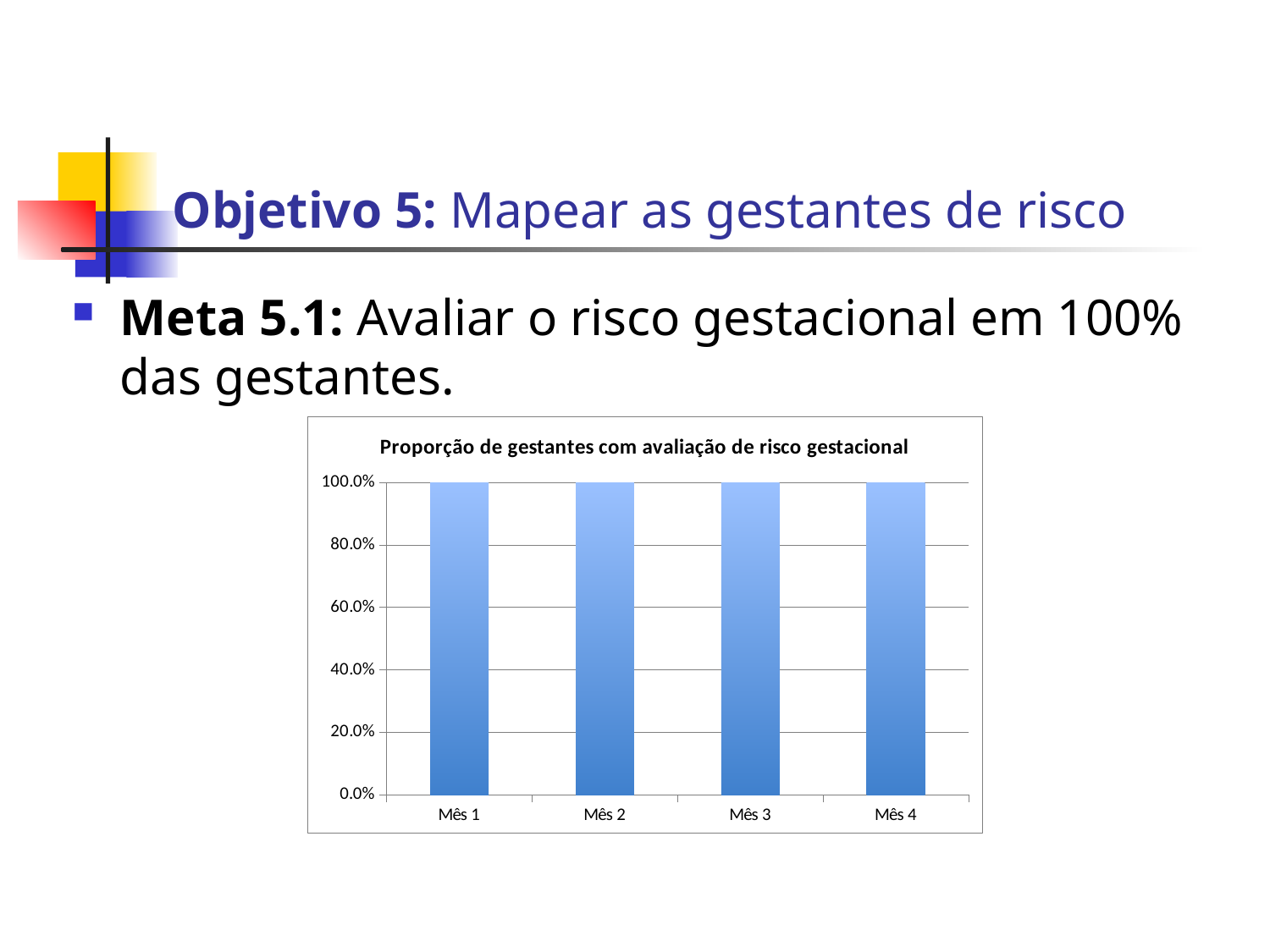
What is the value for Mês 3? 100.0% What kind of chart is shown on the slide? bar chart What is the title of the chart? Proporção de gestantes com avaliação de risco gestacional Is the value for Mês 4 greater or less than 60.0%? greater Do the values rise, fall, or stay the same from Mês 1 to Mês 4? stay the same What is the label of the first category on the x axis? Mês 1 What is the difference between the values for Mês 1 and Mês 3? 0.0% What is the value for Mês 1? 100.0% How many categories are plotted on the x axis of the chart? 4 What is the value for Mês 2? 100.0% Is the value for Mês 2 greater or less than 80.0%? greater What is the value for Mês 4? 100.0%